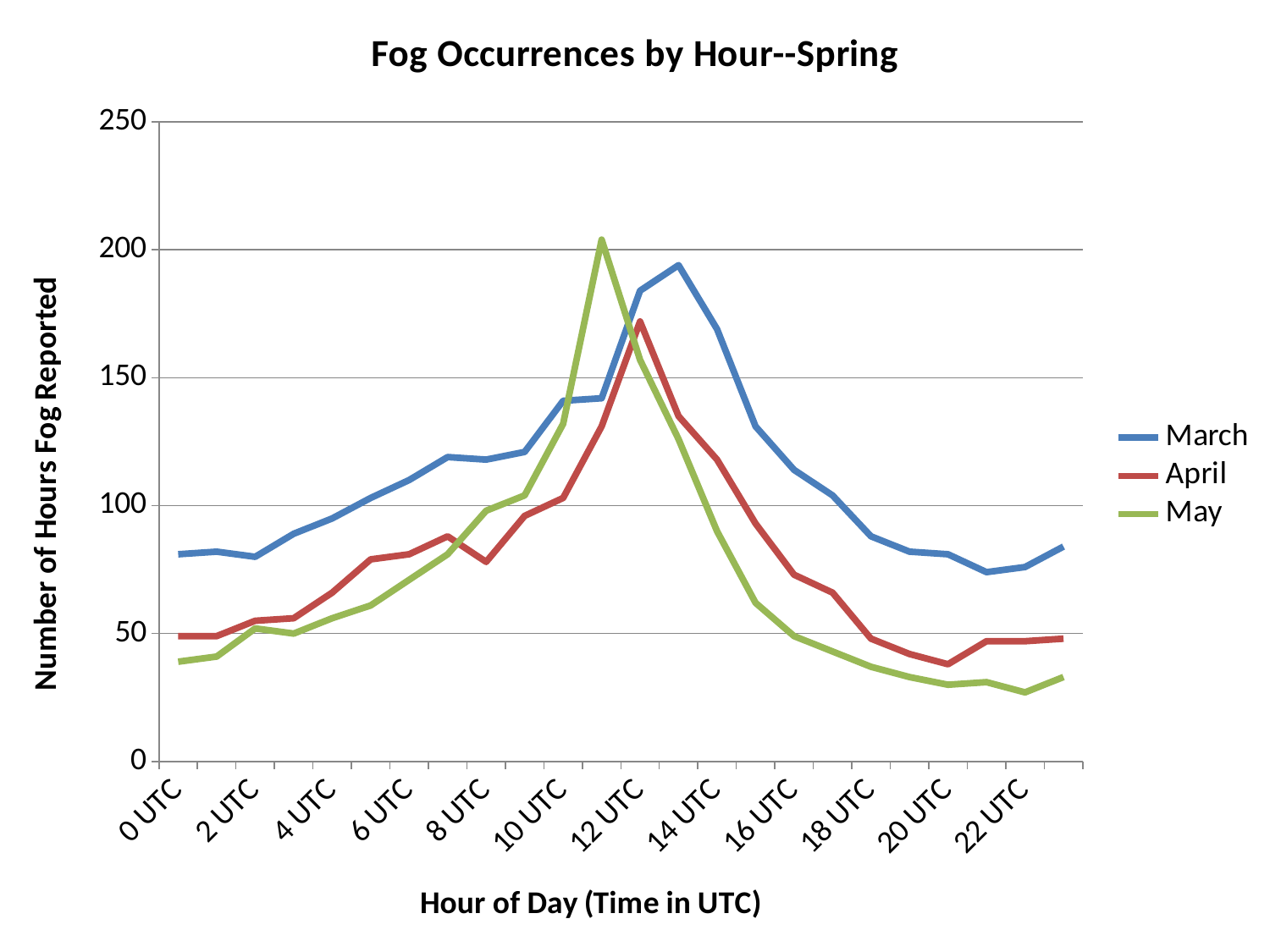
Is the value for March at 0 UTC greater or less than 50? greater Is the value for March at 12 UTC greater or less than 150? greater What is the title of the chart? Fog Occurrences by Hour--Spring At 0 UTC, which series has the higher value, March or May? March Is the value for March at 20 UTC greater or less than 100? less What kind of chart is shown on the slide? line chart Does the March line rise or fall between 14 UTC and 22 UTC? fall What is the label on the vertical axis? Number of Hours Fog Reported Which series reaches the highest peak value on the chart? May How many series does the legend list? 3